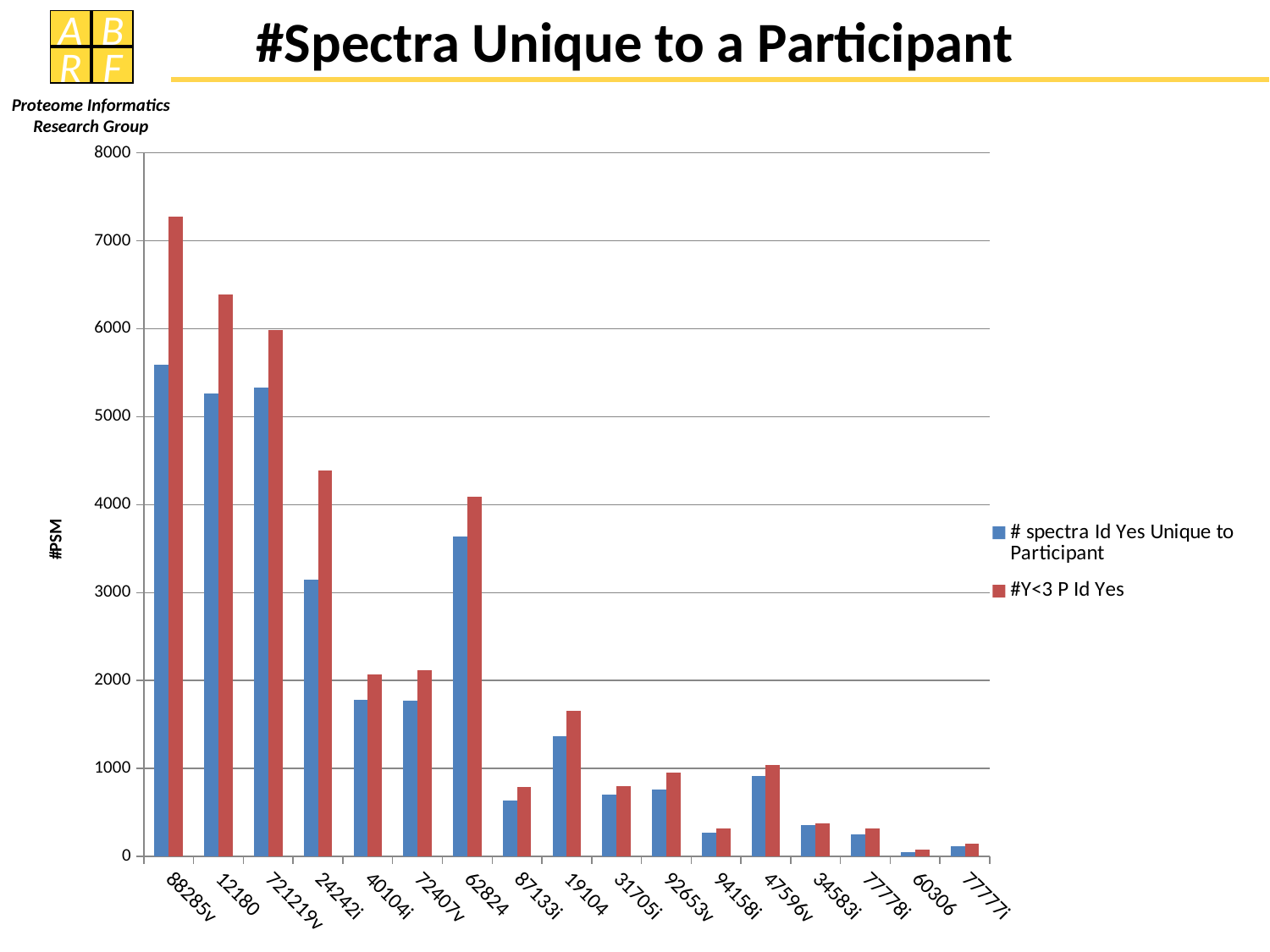
Is the '# spectra Id Yes Unique to Participant' value for 88285v greater or less than 5000? greater What kind of chart is shown on the slide? bar chart How many series does the legend list? 2 How many participant categories are shown on the x axis? 17 Which participant has the highest value for the '#Y<3 P Id Yes' series? 88285v What is the label on the y axis? #PSM Which participant has the lowest value for the '# spectra Id Yes Unique to Participant' series? 60306 Is the '#Y<3 P Id Yes' value for 24242i greater or less than 4000? greater Is the '# spectra Id Yes Unique to Participant' value for 87133i greater or less than 1000? less For the '#Y<3 P Id Yes' series, which is larger: 12180 or 721219v? 12180 For the '# spectra Id Yes Unique to Participant' series, which is larger: 24242i or 62824? 62824